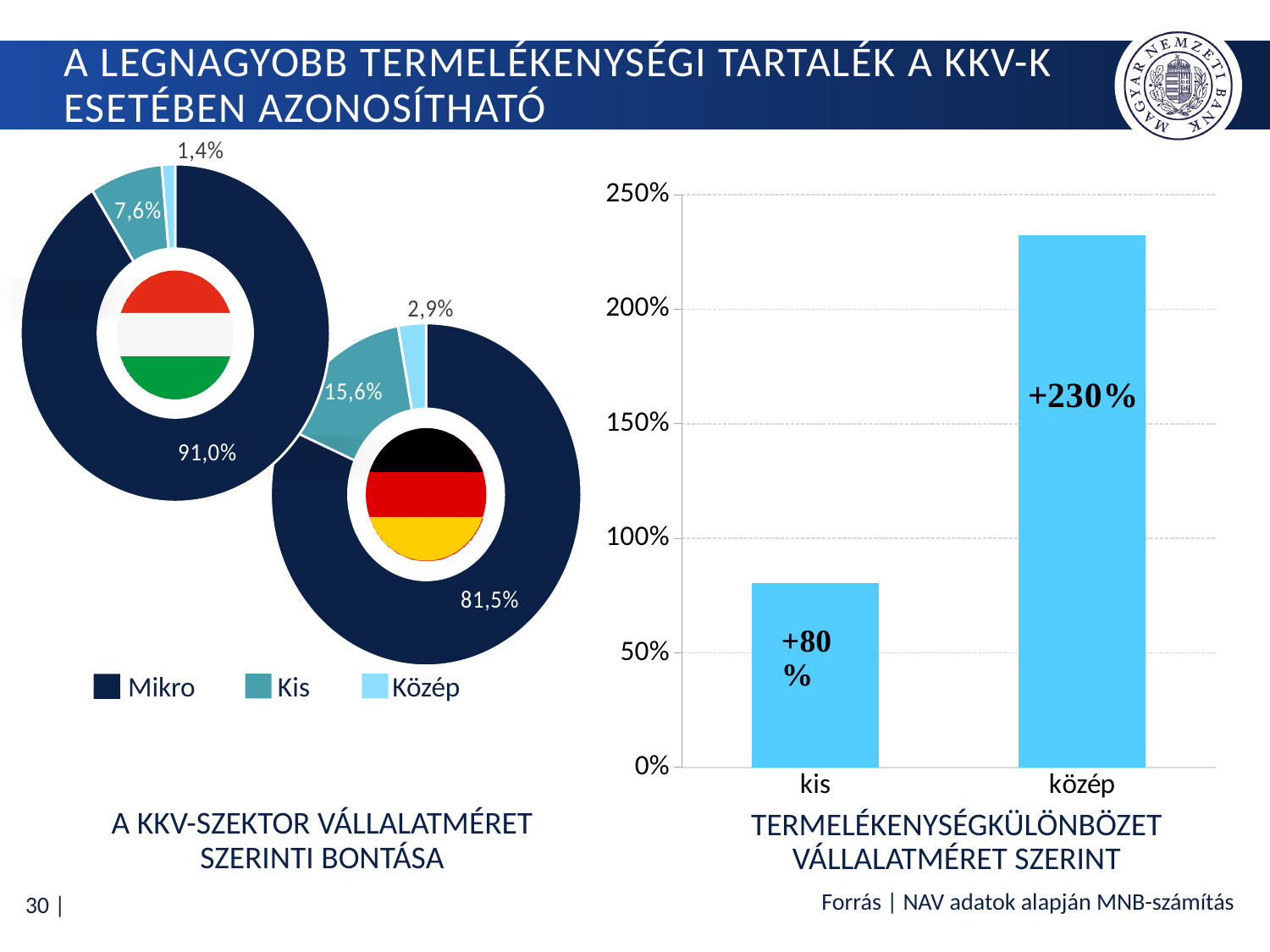
What is the difference between the Kis share in the German-flag doughnut and the Kis share in the Hungarian-flag doughnut? 8,0% In the bar chart titled 'Termelékenységkülönbözet vállalatméret szerint', how many bars are plotted? 2 In the doughnut chart with the Hungarian flag, what share is labelled for the Kis segment? 7,6% In the bar chart titled 'Termelékenységkülönbözet vállalatméret szerint', what value is labelled on the 'kis' bar? +80% In the doughnut chart with the German flag, which segment is the smallest? Közép In the bar chart titled 'Termelékenységkülönbözet vállalatméret szerint', which category has the higher value? közép In the doughnut chart with the German flag, what share is labelled for the Mikro segment? 81,5% How many entries does the legend of the doughnut charts list? 3 What kind of chart is shown on the right side of the slide? Bar chart In the doughnut chart with the Hungarian flag, what share is labelled for the Mikro segment? 91,0% In the bar chart titled 'Termelékenységkülönbözet vállalatméret szerint', what value is labelled on the 'közép' bar? +230% In the doughnut chart with the German flag, what share is labelled for the Közép segment? 2,9%